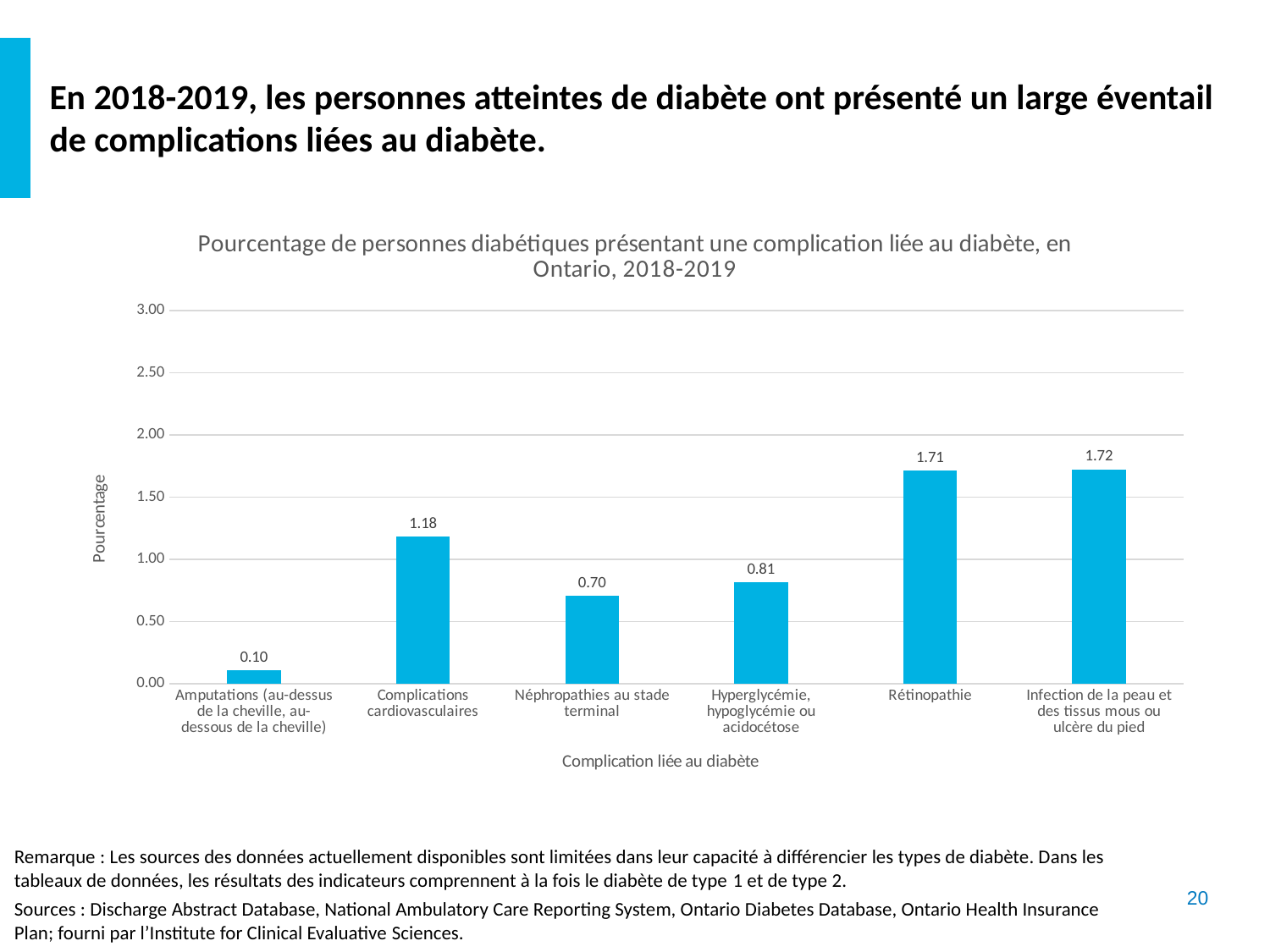
Which is larger, the value for Complications cardiovasculaires or the value for Hyperglycémie, hypoglycémie ou acidocétose? Complications cardiovasculaires What is the difference between the values for Complications cardiovasculaires and Néphropathies au stade terminal? 0.48 What is the value for Néphropathies au stade terminal? 0.70 What is the value for Complications cardiovasculaires? 1.18 Which complication has the lowest percentage? Amputations (au-dessus de la cheville, au-dessous de la cheville) How many complication categories are shown on the x axis? 6 What is the value for Hyperglycémie, hypoglycémie ou acidocétose? 0.81 What is the label of the y axis? Pourcentage What is the difference between the values for Rétinopathie and Amputations? 1.61 What kind of chart is shown on the slide? Bar chart What is the value for Rétinopathie? 1.71 Is the value for Infection de la peau et des tissus mous ou ulcère du pied greater or less than 1.50? greater